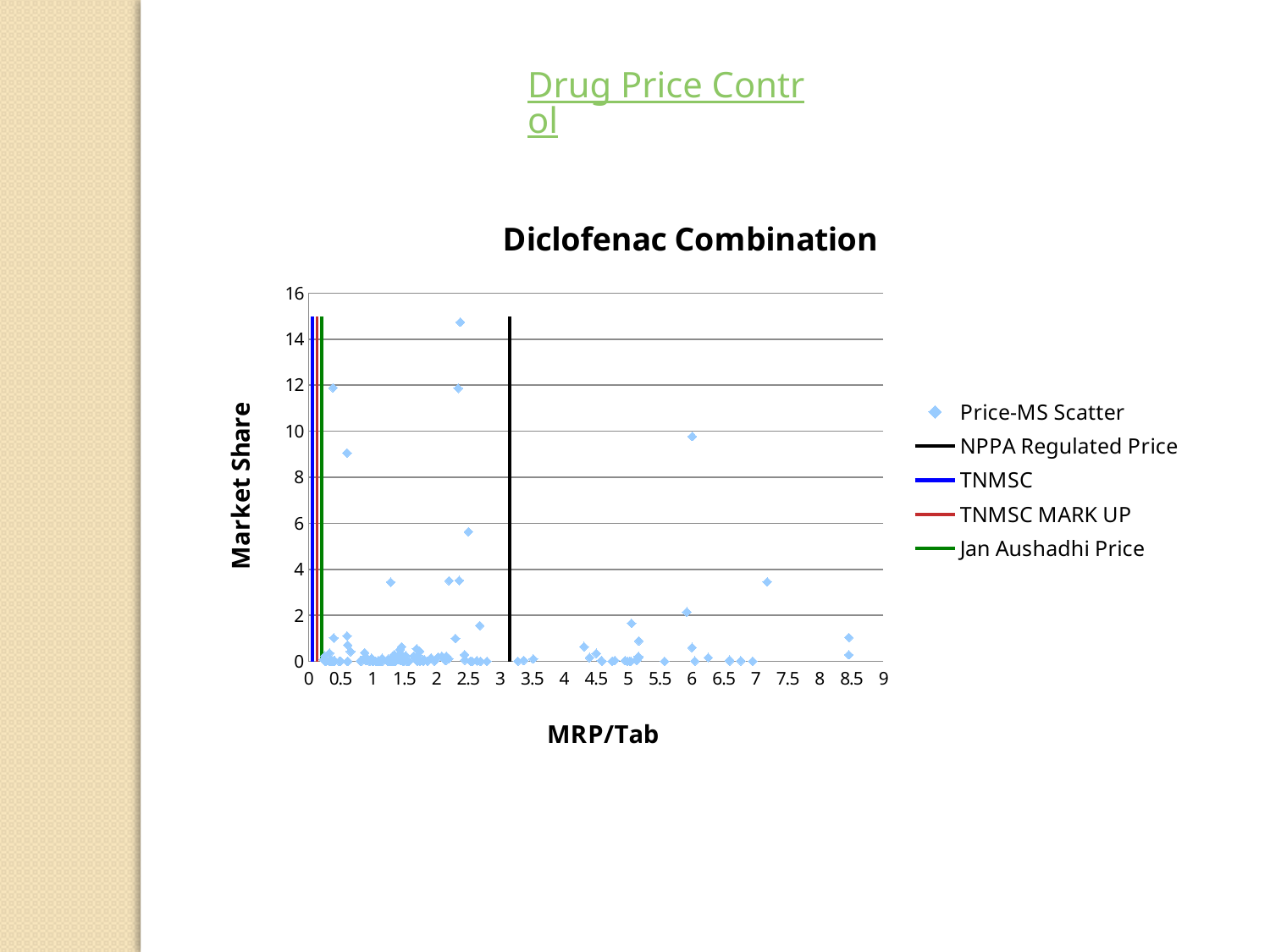
Which is at a higher MRP/Tab: the NPPA Regulated Price line or the TNMSC line? NPPA Regulated Price How many series does the chart legend list? 5 Is the highest Market Share value plotted in the Price-MS Scatter series greater or less than 14? greater What is the label of the x axis? MRP/Tab What kind of chart is shown on the slide? scatter chart Is the Jan Aushadhi Price line positioned at an MRP/Tab greater or less than 0.5? less What is the highest value shown on the MRP/Tab axis? 9 What is the highest value shown on the Market Share axis? 16 Is the Market Share of the scatter point plotted near an MRP/Tab of 7.2 greater or less than 4? less Which is at a higher MRP/Tab: the Jan Aushadhi Price line or the NPPA Regulated Price line? NPPA Regulated Price What is the title of the chart? Diclofenac Combination